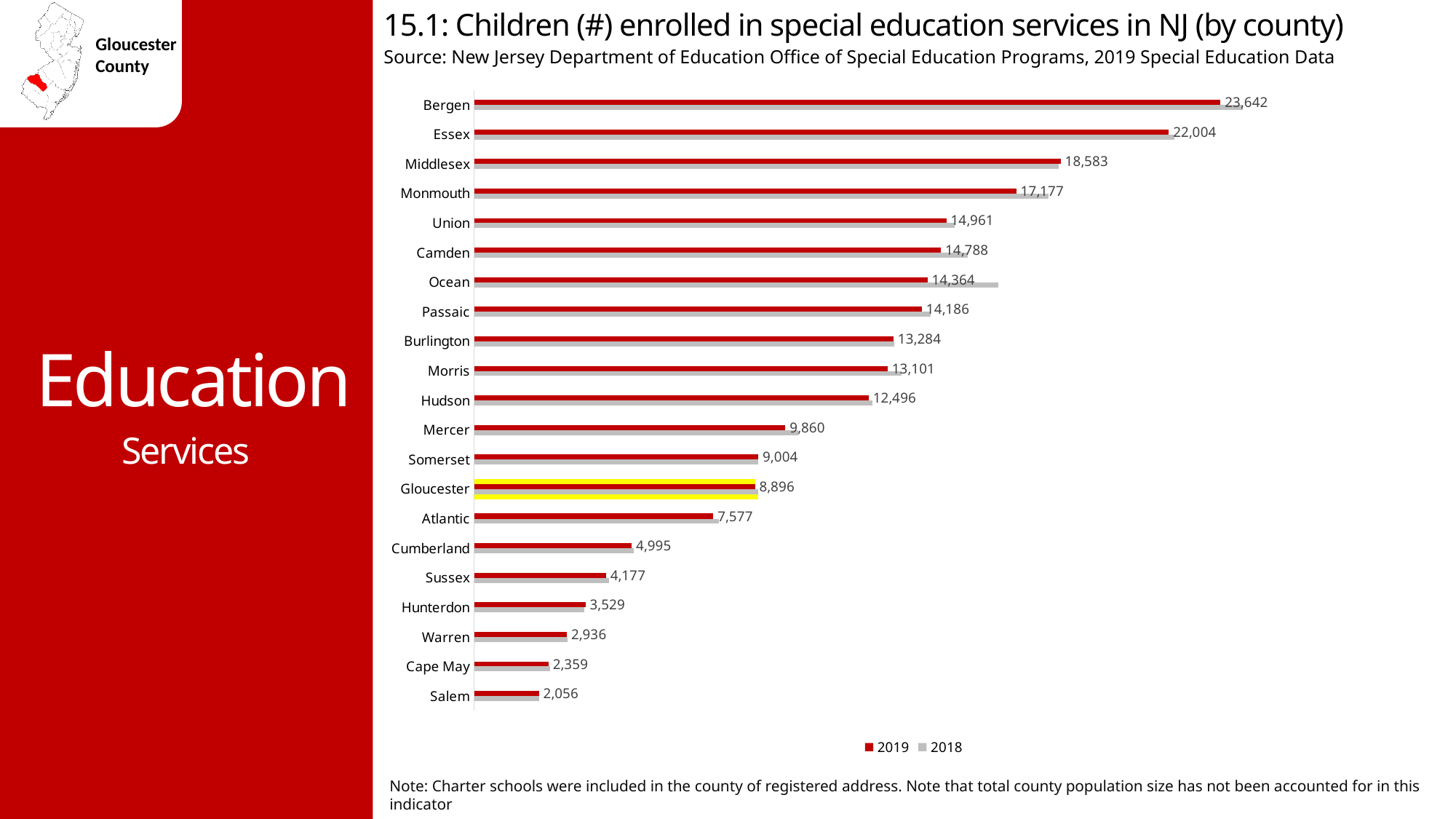
Which county has the highest 2019 value? Bergen Which county has the lowest 2019 value? Salem How many children were enrolled in special education services in Camden county in 2019? 14,788 How many counties are shown on the chart? 21 Which county has the larger 2019 value, Mercer or Somerset? Mercer What is the 2019 value for Salem county? 2,056 How many series does the legend list? 2 For Ocean county, which year has the larger value, 2018 or 2019? 2018 What is the difference between the 2019 values for Bergen and Essex? 1,638 What is the difference between the 2019 values for Gloucester and Atlantic? 1,319 What type of chart is shown on the slide? Bar chart What is the 2019 value for Gloucester county? 8,896